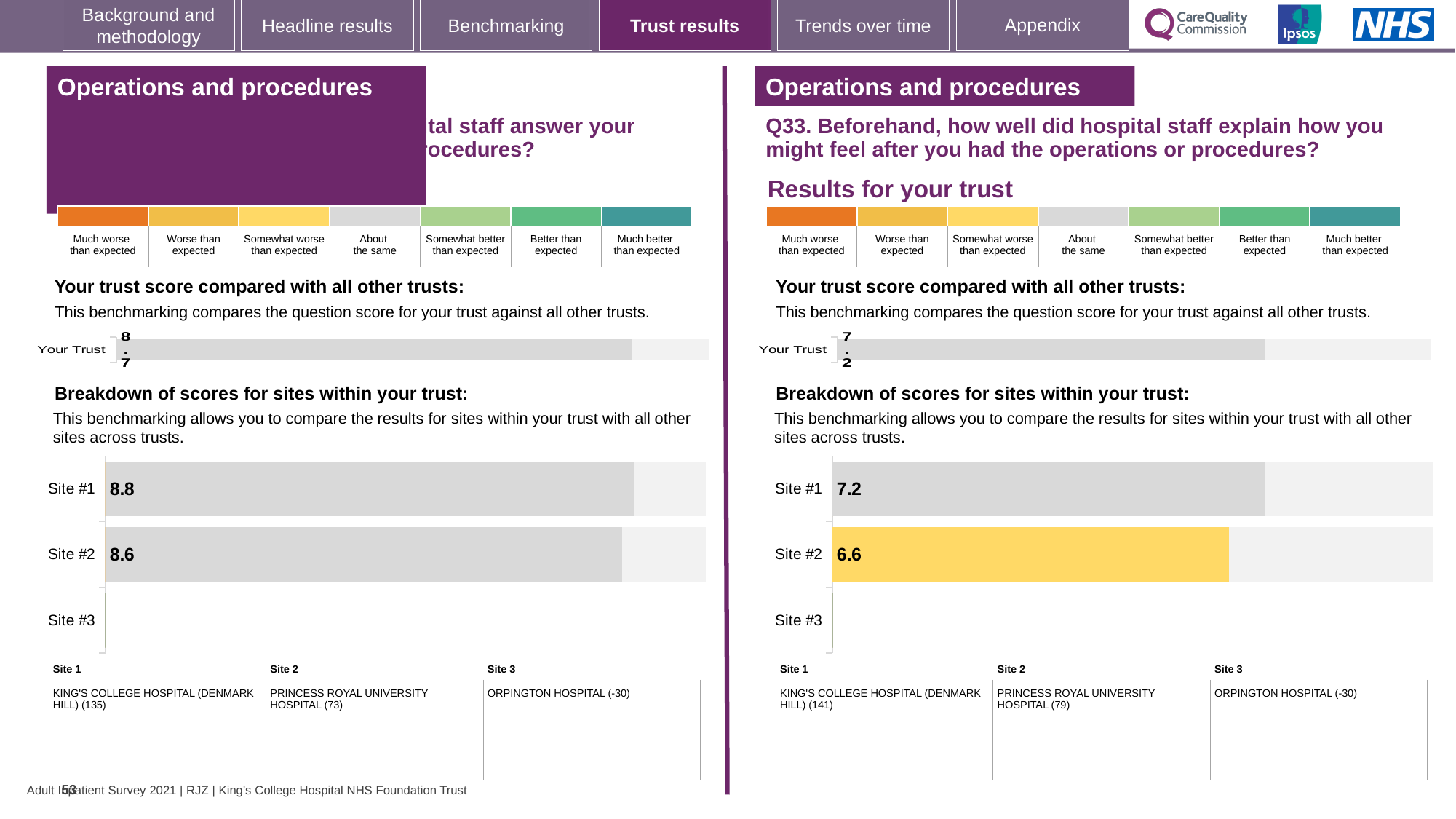
On the right-hand chart (Q33), what colour is the bar for Site #2? Yellow On the left-hand chart, what is the difference between the Site #1 and Site #2 scores? 0.2 On the left-hand chart, what is the score shown for Your Trust? 8.7 On the left-hand chart, which site has the higher score, Site #1 or Site #2? Site #1 On the right-hand chart (Q33), what is the score shown for Your Trust? 7.2 On the left-hand chart, what is the score for Site #1? 8.8 On the right-hand chart (Q33), which site has the lowest score among those with a bar shown? Site #2 On the right-hand chart (Q33), what is the score for Site #2? 6.6 What type of chart is used to show the breakdown of scores for sites within the trust? Bar chart On the left-hand chart, what is the score for Site #2? 8.6 On the right-hand chart (Q33), what is the score for Site #1? 7.2 On the right-hand chart (Q33), what is the difference between the Site #1 and Site #2 scores? 0.6